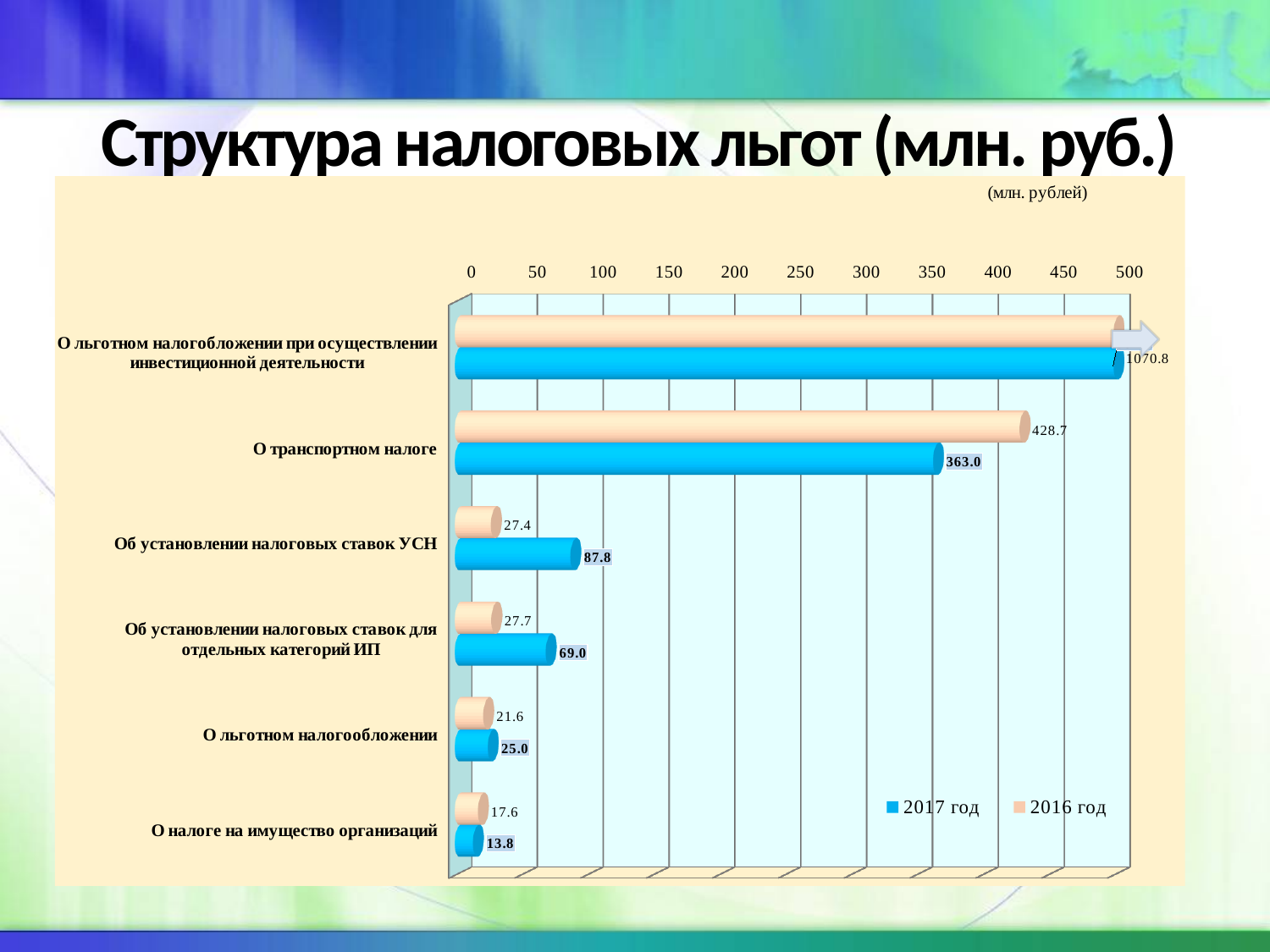
What is the value for 2016 год for "О налоге на имущество организаций"? 17.6 What is the value for 2017 год for "О транспортном налоге"? 363.0 Which category has the lowest value for 2017 год? О налоге на имущество организаций What kind of chart is shown on the slide? bar chart What is the difference between the 2016 год and 2017 год values for "О транспортном налоге"? 65.7 How many series does the legend list? 2 Is the 2016 год value for "О льготном налогообложении при осуществлении инвестиционной деятельности" greater or less than 450? greater What colour are the bars for the 2016 год series? peach What is the value for 2017 год for "Об установлении налоговых ставок УСН"? 87.8 How many categories are shown on the chart? 6 What is the value for 2016 год for "О транспортном налоге"? 428.7 Which is larger for "Об установлении налоговых ставок для отдельных категорий ИП": the 2017 год value or the 2016 год value? 2017 год